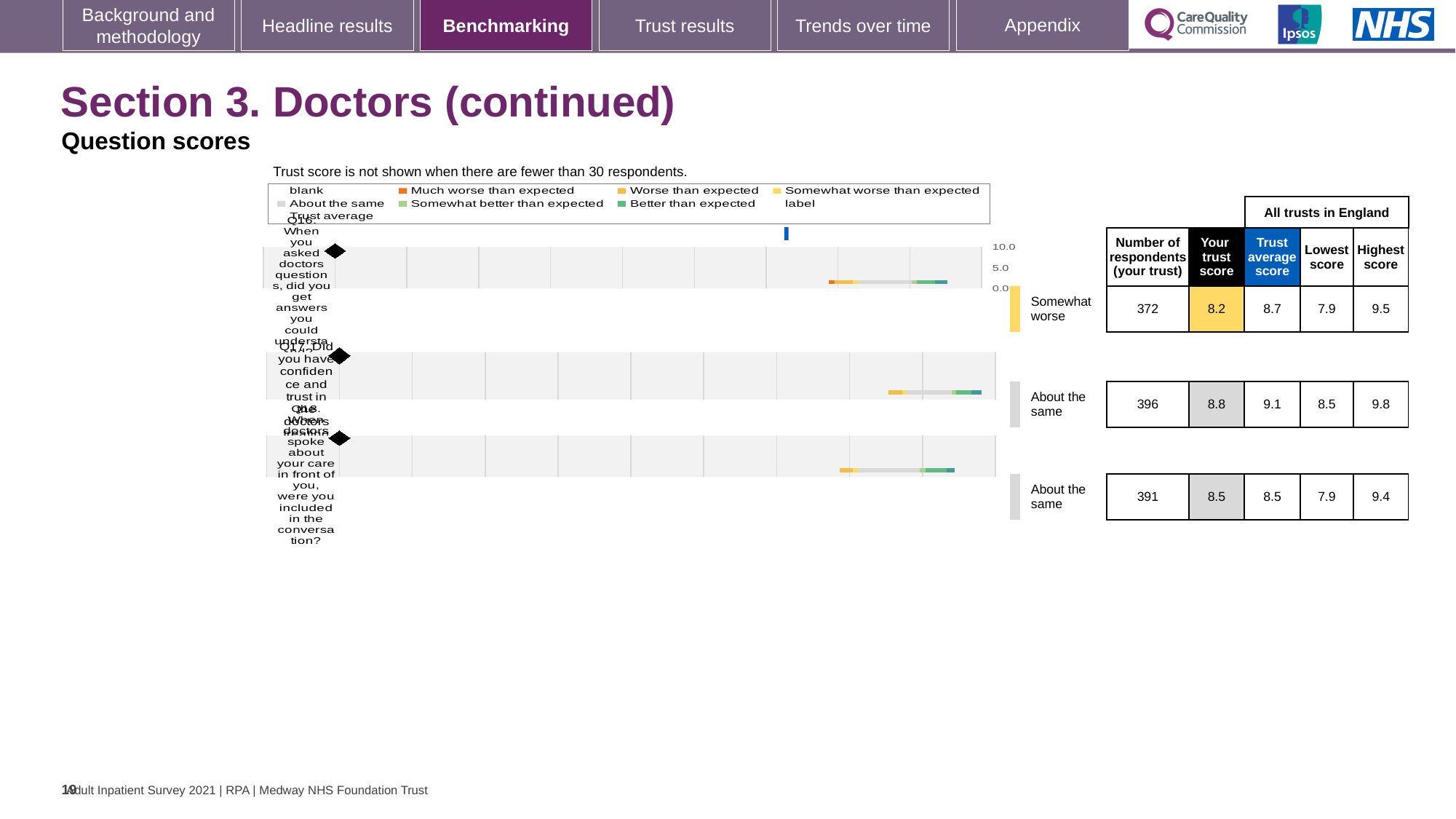
What is the benchmark category shown for Q16? Somewhat worse Is the trust score for Q17 larger or smaller than the trust average score for Q17? smaller How many questions (categories) are plotted in the question scores chart? 3 What is the trust score for Q16 (When you asked doctors questions, did you get answers you could understand)? 8.2 What is the highest score across all trusts in England for Q17? 9.8 What is the difference between the trust score and the trust average score for Q16? 0.5 What is the trust average score for Q17 (Did you have confidence and trust in the doctors treating you)? 9.1 What is the difference between the highest score and the lowest score across all trusts in England for Q16? 1.6 What kind of chart is used to show the question scores on this slide? bar chart How many respondents answered Q18 (When doctors spoke about your care in front of you, were you included in the conversation)? 391 Which question has the lowest trust score for this trust? Q16 Which question has the highest trust score for this trust? Q17